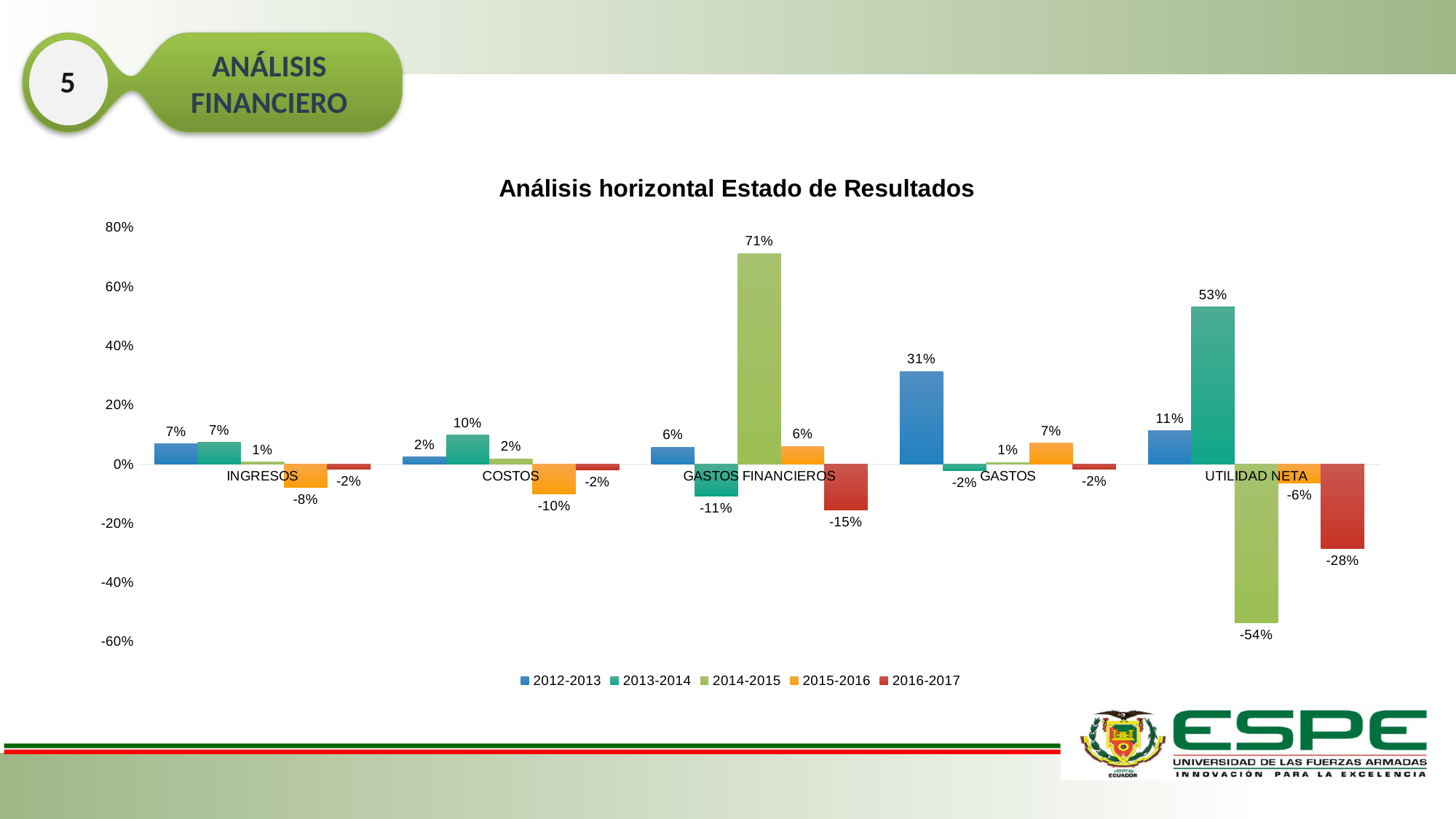
How many series does the legend list? 5 How many categories are shown on the x axis? 5 What is the value for COSTOS in the 2015-2016 series? -10% What type of chart is shown on the slide? bar chart Which category has the lowest value in the 2016-2017 series? UTILIDAD NETA What is the value for GASTOS FINANCIEROS in the 2014-2015 series? 71% Which is larger for GASTOS FINANCIEROS: the 2012-2013 value or the 2013-2014 value? 2012-2013 What is the value for UTILIDAD NETA in the 2014-2015 series? -54% Which category has the highest value in the 2013-2014 series? UTILIDAD NETA What is the value for GASTOS in the 2012-2013 series? 31% What is the title of the chart? Análisis horizontal Estado de Resultados What is the difference between the 2013-2014 value and the 2012-2013 value for UTILIDAD NETA? 42%